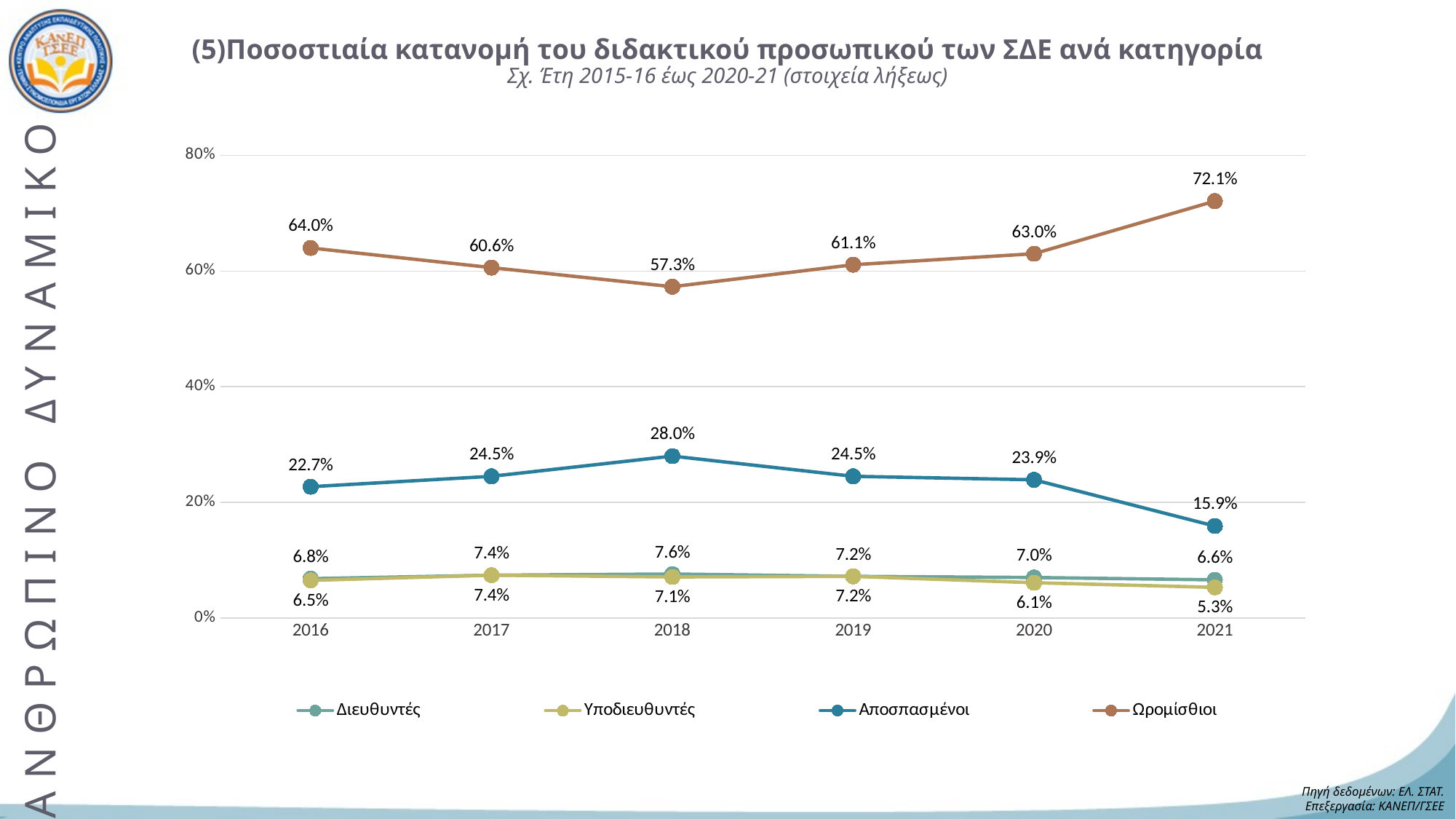
In which year is the value for Αποσπασμένοι the highest? 2018 In which year is the value for Ωρομίσθιοι the lowest? 2018 Which series has the larger value in 2019, Ωρομίσθιοι or Αποσπασμένοι? Ωρομίσθιοι What is the value for Αποσπασμένοι in 2018? 28.0% What is the value for Υποδιευθυντές in 2021? 5.3% What is the difference between the Ωρομίσθιοι values in 2021 and 2020? 9.1% What is the value for Ωρομίσθιοι in 2018? 57.3% How many years are shown on the x axis? 6 How many series does the legend list? 4 What type of chart is shown on the slide? line chart What is the value for Ωρομίσθιοι in 2021? 72.1% Is the value for Αποσπασμένοι in 2021 greater or less than 20%? less